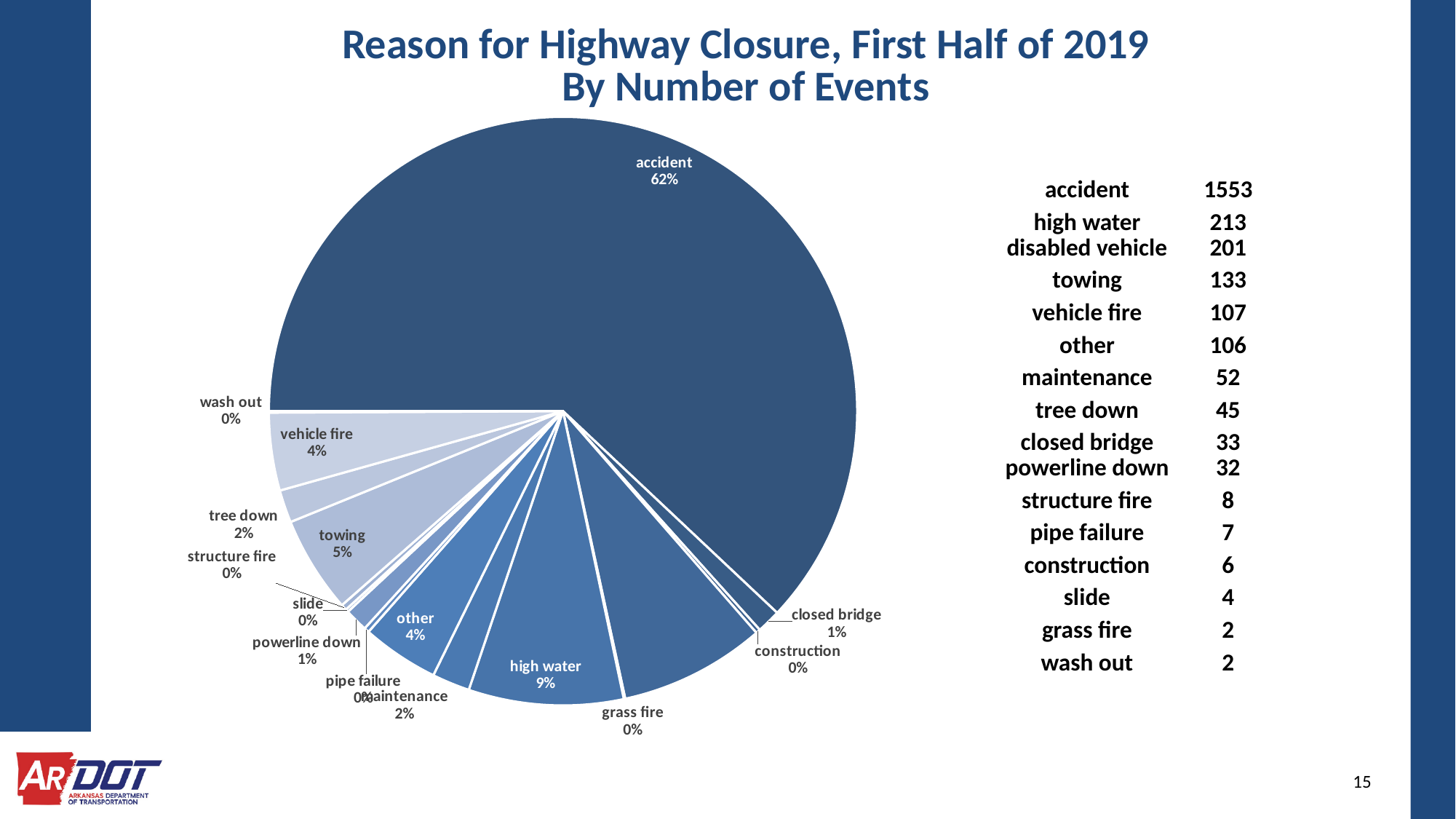
What percentage is shown for high water in the pie chart? 9% According to the table, how many more events were due to high water than to disabled vehicle? 12 What percentage is shown for towing in the pie chart? 5% Which reason for highway closure has the largest slice of the pie chart? accident According to the table beside the pie chart, how many events were due to tree down? 45 Which has the larger share in the pie chart, towing or vehicle fire? towing What is the title of the chart on the slide? Reason for Highway Closure, First Half of 2019 By Number of Events What percentage is shown for maintenance in the pie chart? 2% What share of highway closure events is labelled for accident in the pie chart? 62% How many reasons for highway closure are listed in the table beside the pie chart? 16 What percentage is shown for closed bridge in the pie chart? 1% What kind of chart is shown on the slide? pie chart